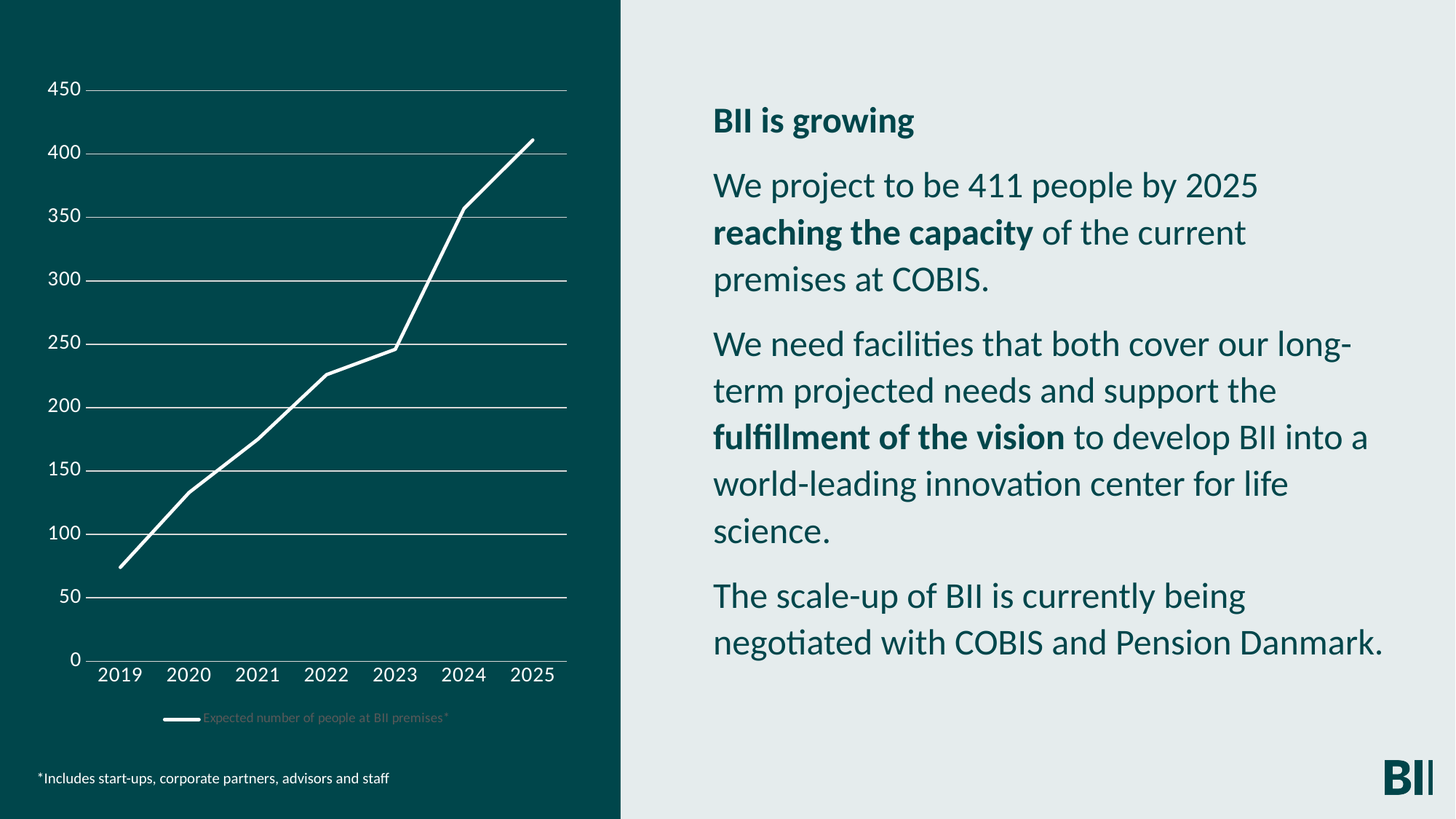
How many years are plotted on the x axis of the chart? 7 What kind of chart is shown on the slide? line chart How many series does the chart's legend list? 1 Is the value for 2021 greater or less than 150? greater Which year has the larger value, 2022 or 2024? 2024 Is the value for 2019 greater or less than 100? less Is the value for 2022 greater or less than 250? less Do the values in the chart rise or fall from 2019 to 2025? rise Which year has the highest value in the chart? 2025 What is the legend entry for the series plotted in the chart? Expected number of people at BII premises* Which year has the lowest value in the chart? 2019